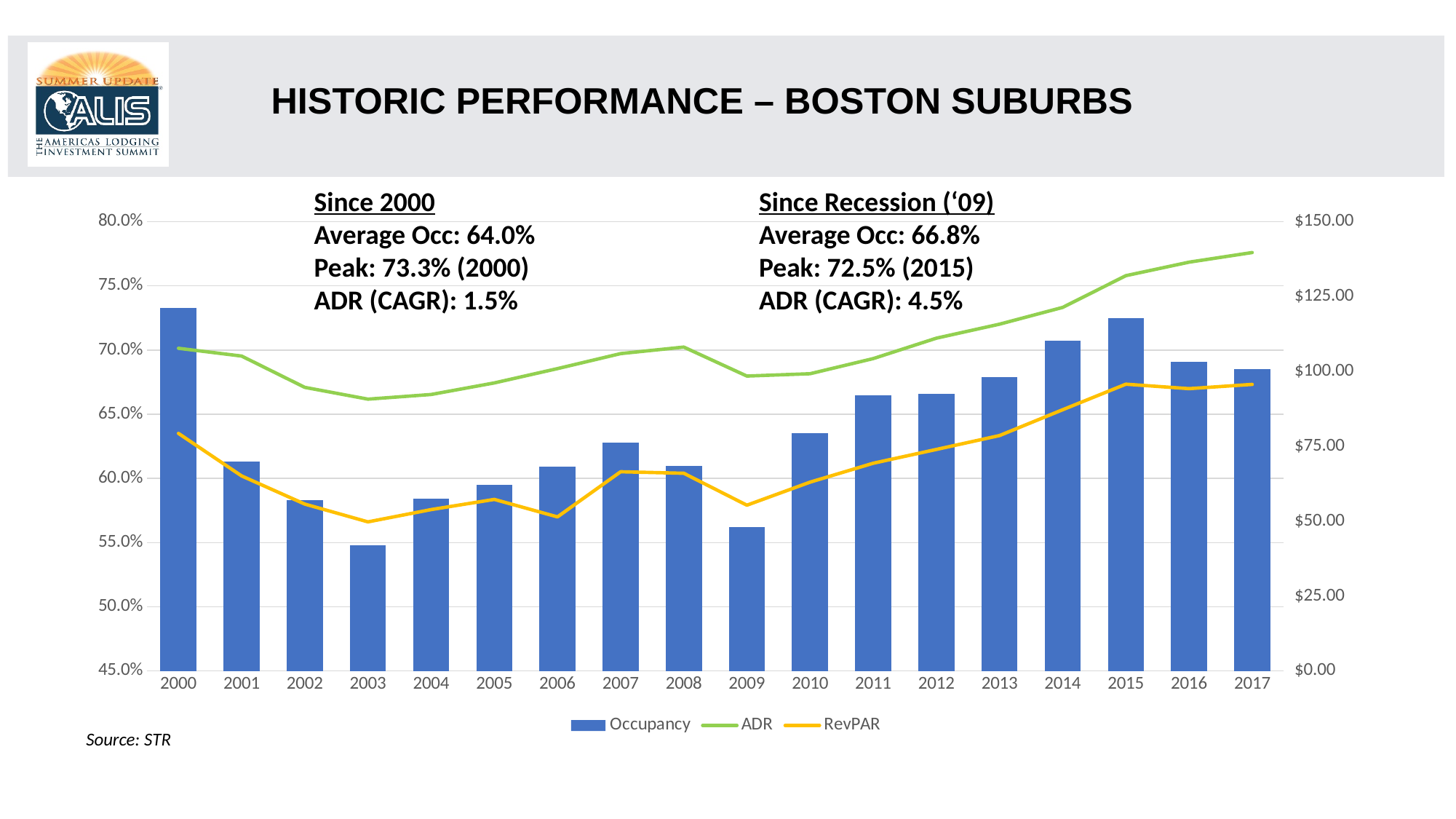
What was the peak occupancy since 2000, according to the text on the slide? 73.3% (2000) Which year has the highest Occupancy bar? 2000 Is the Occupancy value for 2009 greater or less than 60.0%? less How many series does the legend list? 3 Does the ADR line rise or fall from 2009 to 2017? rise What kind of chart is shown on the slide? A combined bar and line chart What was the peak occupancy since the 2009 recession, according to the text on the slide? 72.5% (2015) How many years are shown on the x axis? 18 Which series are listed in the legend? Occupancy, ADR, RevPAR Is the ADR value for 2017 greater or less than $125.00? greater Is the RevPAR value for 2003 greater or less than $75.00? less Which year has the lowest Occupancy bar? 2003